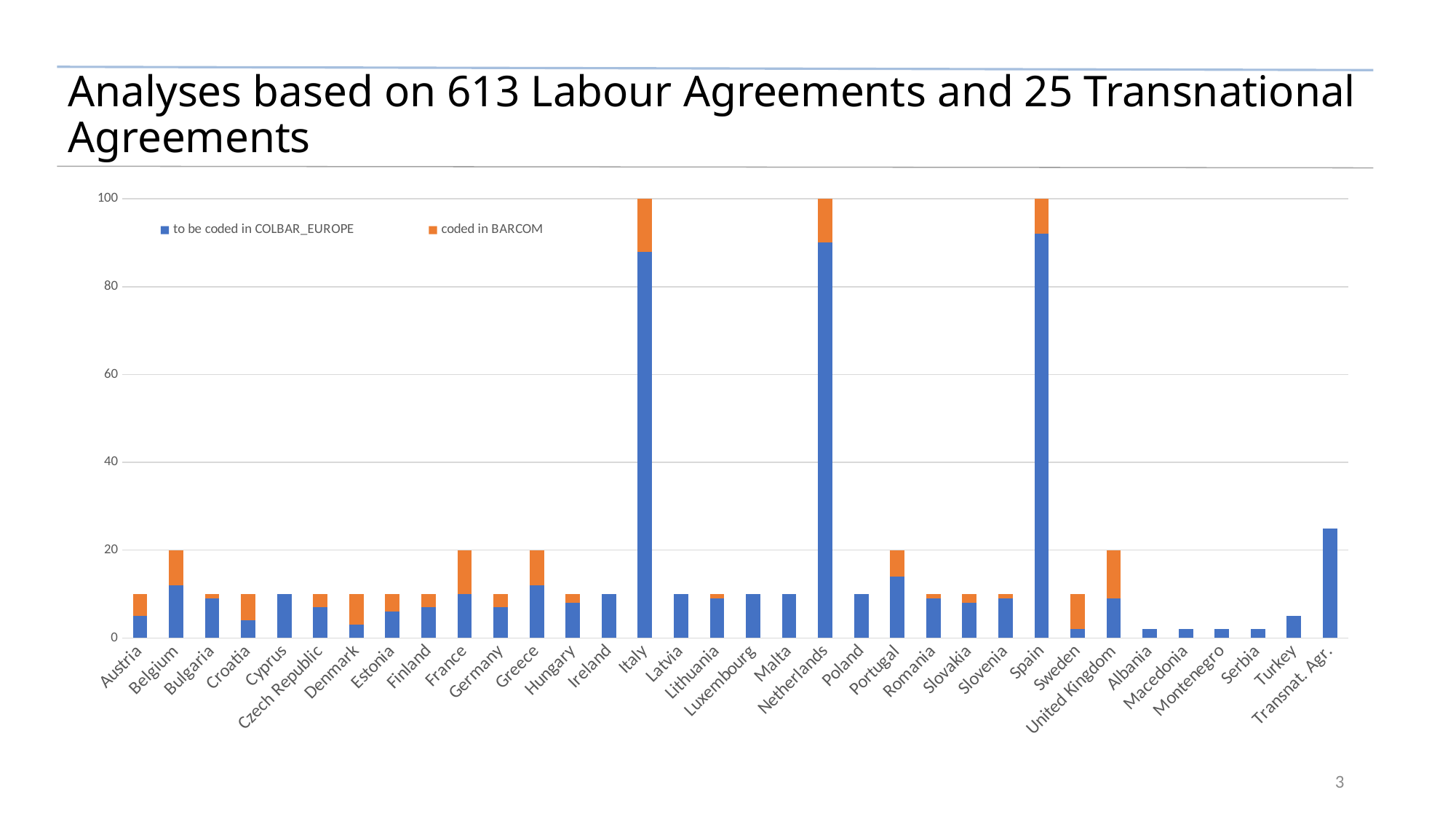
Is the value for Turkey greater or less than 20? less Is the value for Transnat. Agr. greater or less than 20? greater What is the total height of the stacked bar for Netherlands? 100 Which has a taller bar, Transnat. Agr. or Turkey? Transnat. Agr. How many categories are shown on the x axis? 34 Is the total value for Portugal greater or less than 40? less How many series does the legend list? 2 What kind of chart is shown on the slide? stacked bar chart What is the total height of the stacked bar for United Kingdom? 20 Which series is shown in orange in the legend? coded in BARCOM Which has a taller bar, Spain or Germany? Spain What is the total height of the stacked bar for Italy? 100